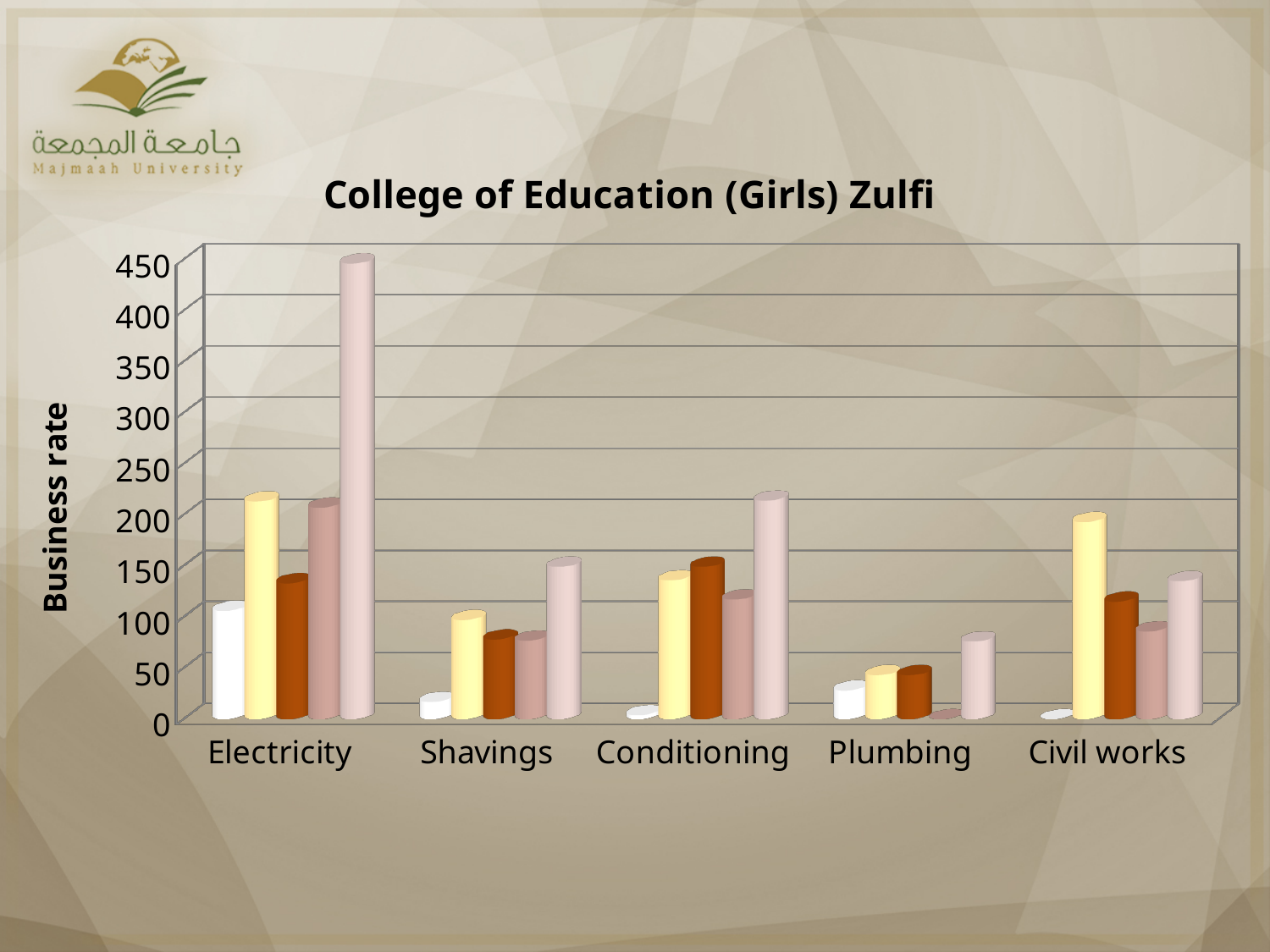
Is the tallest bar in the Electricity category greater or less than 400? greater Which category has the taller tallest bar, Electricity or Plumbing? Electricity Is the tallest bar in the Shavings category greater or less than 200? less How many bars are plotted for each category in the chart? 5 Is the tallest bar in the Plumbing category greater or less than 100? less What kind of chart is shown on the slide? bar chart Which category contains the tallest bar in the chart? Electricity How many categories are shown on the x axis of the chart? 5 What is the label on the vertical axis of the chart? Business rate What is the title of the chart? College of Education (Girls) Zulfi